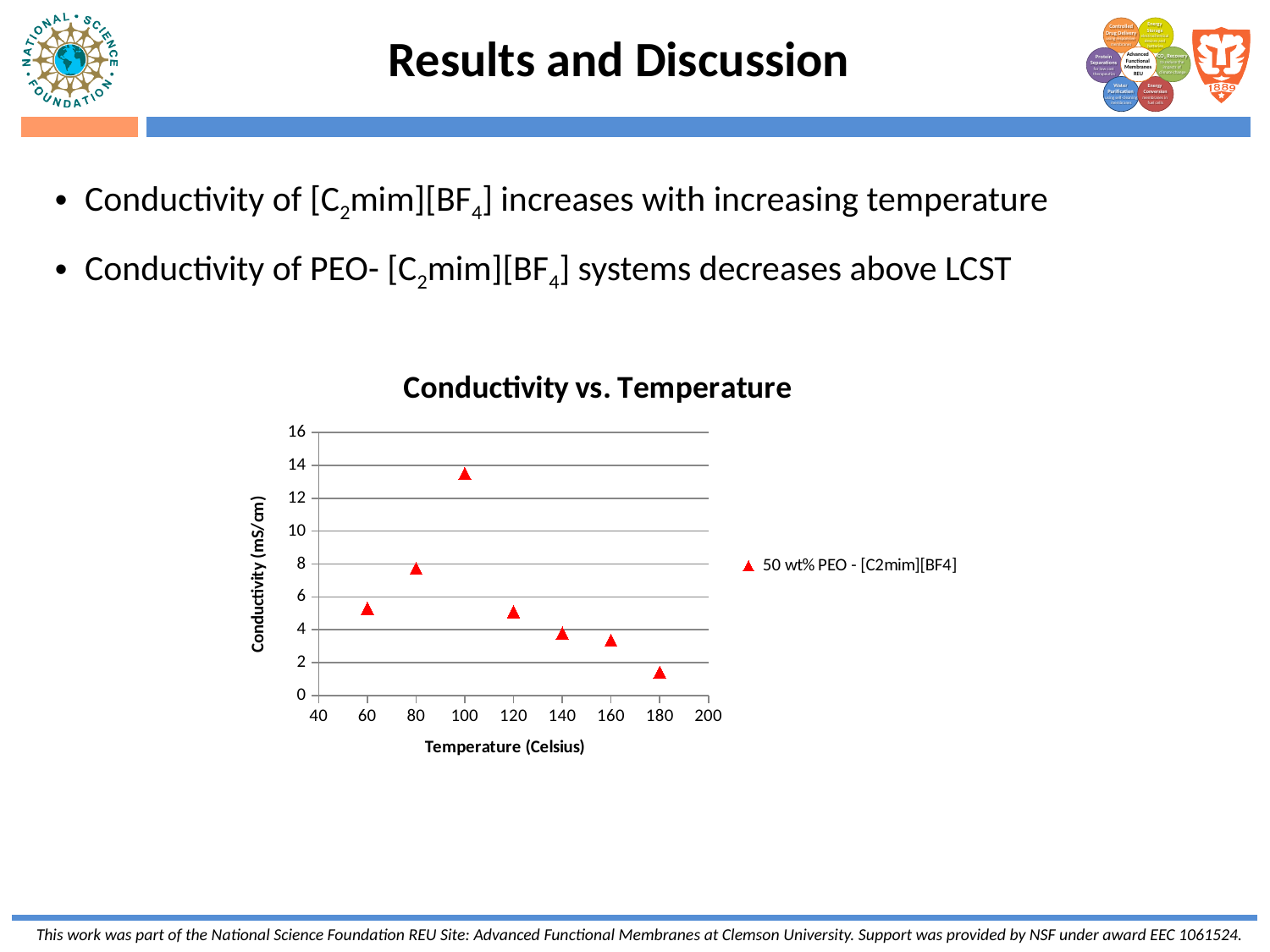
Do the conductivity values rise or fall as temperature increases from 100 to 180 Celsius? fall Is the conductivity at 80 Celsius greater or less than 6 mS/cm? greater Is the conductivity at 180 Celsius greater or less than 2 mS/cm? less Which has the higher conductivity, the point at 80 Celsius or the point at 140 Celsius? 80 Celsius What is the name of the series shown in the chart legend? 50 wt% PEO - [C2mim][BF4] How many series does the chart legend list? 1 At which temperature is the conductivity lowest? 180 What kind of chart is shown on the slide? scatter chart What is the title of the chart? Conductivity vs. Temperature At which temperature is the conductivity highest? 100 Is the conductivity at 100 Celsius greater or less than 12 mS/cm? greater How many data points are plotted in the chart? 7